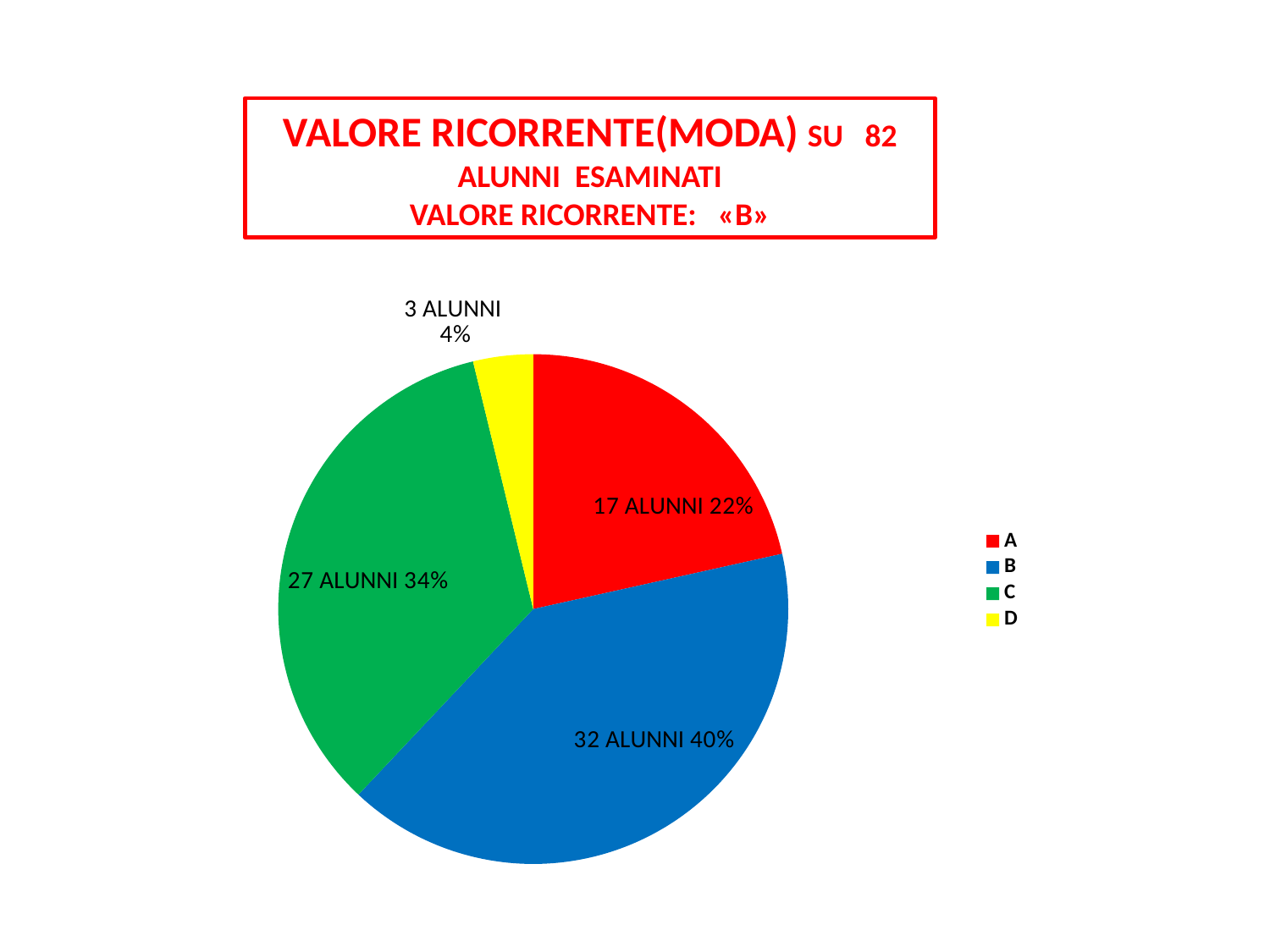
Which category has the largest slice? B What percentage of the pie does category A represent? 22% What kind of chart is shown on the slide? pie chart How many entries does the legend list? 4 How many alunni are in category B? 32 ALUNNI Which category has the smallest slice? D What colour is the slice for category C? green Which category has more alunni, A or C? C What percentage of the pie does category C represent? 34% How many alunni are in category D? 3 ALUNNI What is the difference in number of alunni between category B and category A? 15 How many slices does the pie chart have? 4